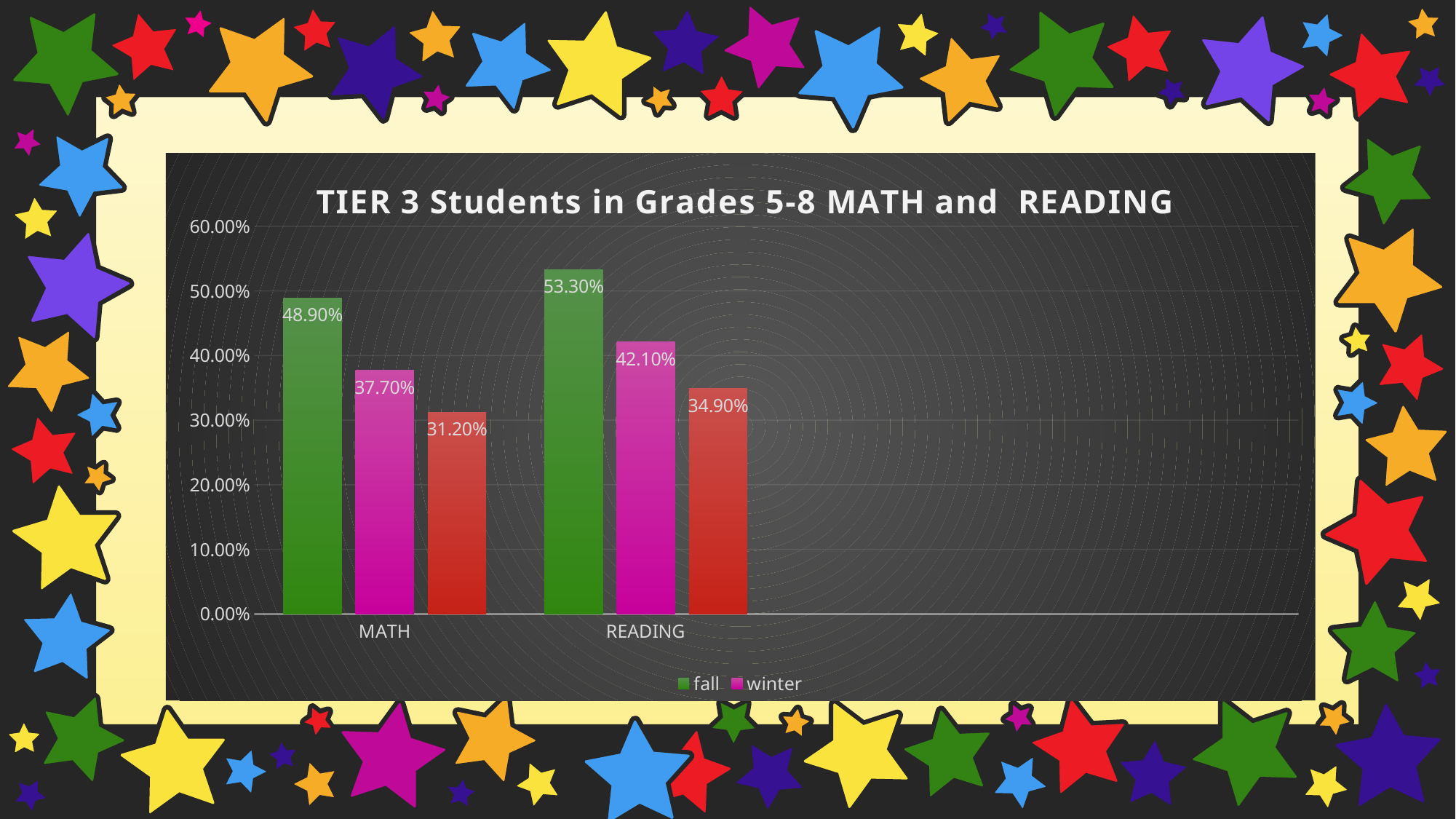
What is the difference between the fall and winter values for MATH? 11.20% What is the fall value for MATH? 48.90% Is the winter value for READING greater or less than 40.00%? greater What is the title of the chart? TIER 3 Students in Grades 5-8 MATH and READING Which category has the higher fall value, MATH or READING? READING How many categories are shown on the x axis? 2 How many series does the legend list? 2 What is the fall value for READING? 53.30% What kind of chart is shown on the slide? bar chart What is the winter value for READING? 42.10% What is the winter value for MATH? 37.70% What is the difference between the fall values for READING and MATH? 4.40%